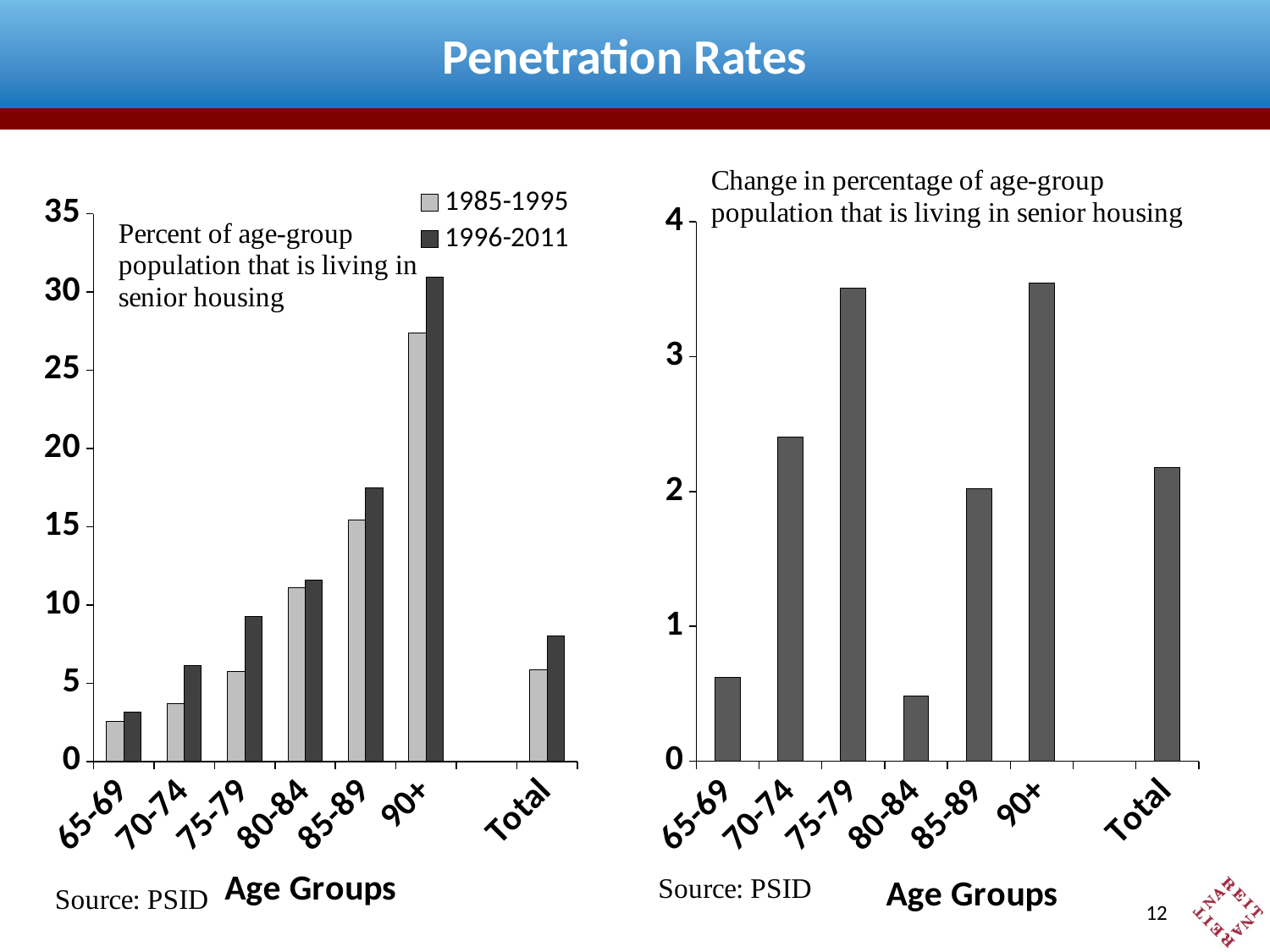
In the left chart, how many series does the legend list? 2 In the left chart, for the 75-79 age group, which series has the larger value, 1985-1995 or 1996-2011? 1996-2011 In the left chart, which age group has the lowest value for the 1985-1995 series? 65-69 In the right chart, which has the larger value, 70-74 or 85-89? 70-74 In the right chart, 'Change in percentage of age-group population that is living in senior housing', is the value for 70-74 greater or less than 2? greater In the left chart, how many age-group categories are shown on the x axis? 7 In the right chart, is the value for 80-84 greater or less than 1? less In the left chart, is the 1985-1995 value for 90+ greater or less than 25? greater In the left chart, which age group has the highest value for the 1996-2011 series? 90+ In the left chart, do the 1996-2011 values rise or fall from 65-69 through 90+? rise What kind of chart is the left chart, 'Percent of age-group population that is living in senior housing'? bar chart